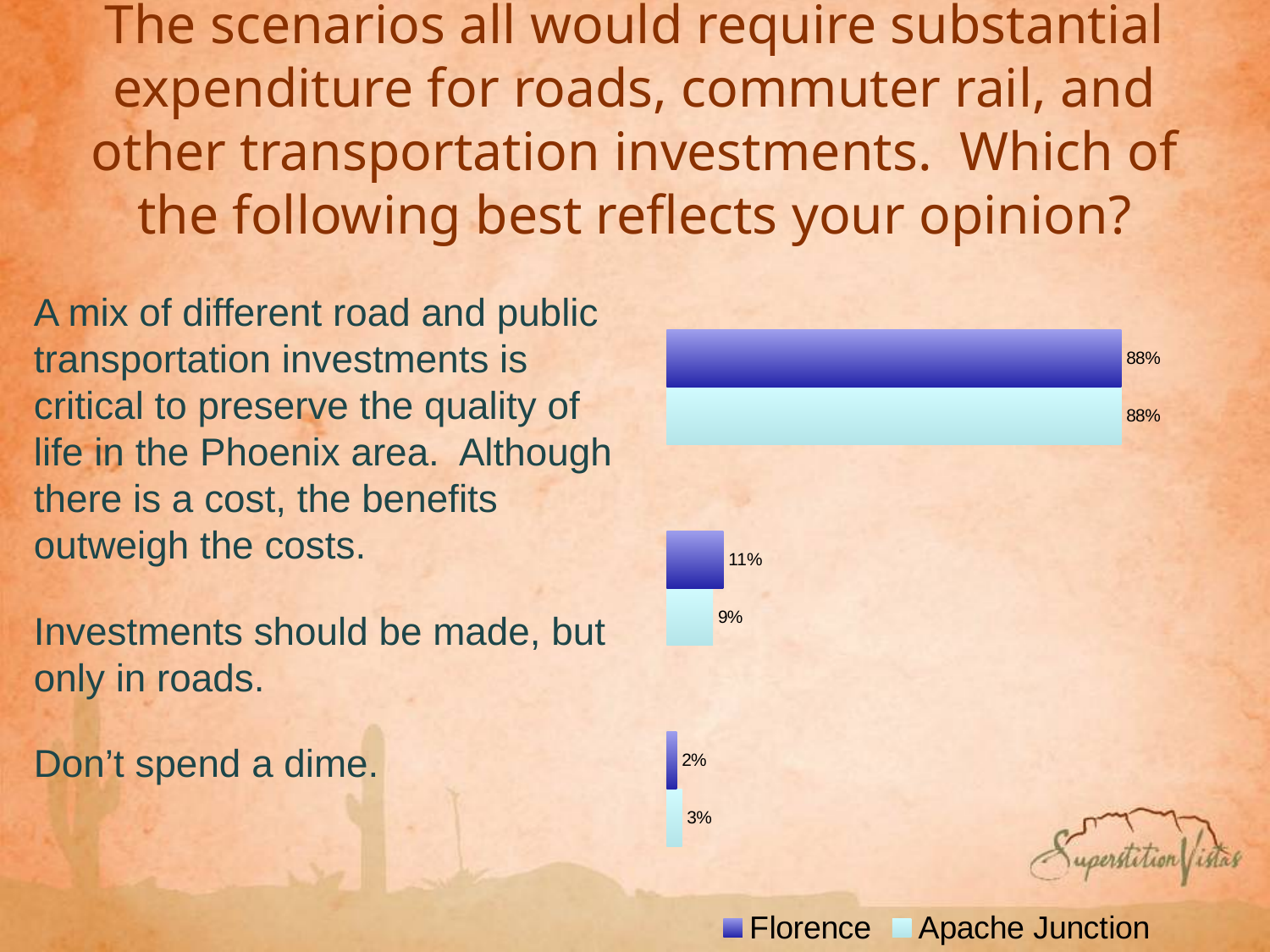
What is the difference between the Florence and Apache Junction percentages for "Investments should be made, but only in roads"? 2% What percentage of Apache Junction respondents said investments should be made, but only in roads? 9% Which series is shown in dark blue in the legend? Florence Which opinion received the highest share of Florence respondents? A mix of different road and public transportation investments is critical What percentage of Apache Junction respondents said "Don't spend a dime"? 3% What percentage of Florence respondents chose the option that a mix of road and public transportation investments is critical? 88% Which opinion received the lowest share of Apache Junction respondents? Don't spend a dime How many series does the legend list? 2 What type of chart is shown on the slide? Bar chart What percentage of Florence respondents said "Don't spend a dime"? 2% How many opinion categories are shown in the chart? 3 For "Don't spend a dime", which has the larger percentage, Florence or Apache Junction? Apache Junction